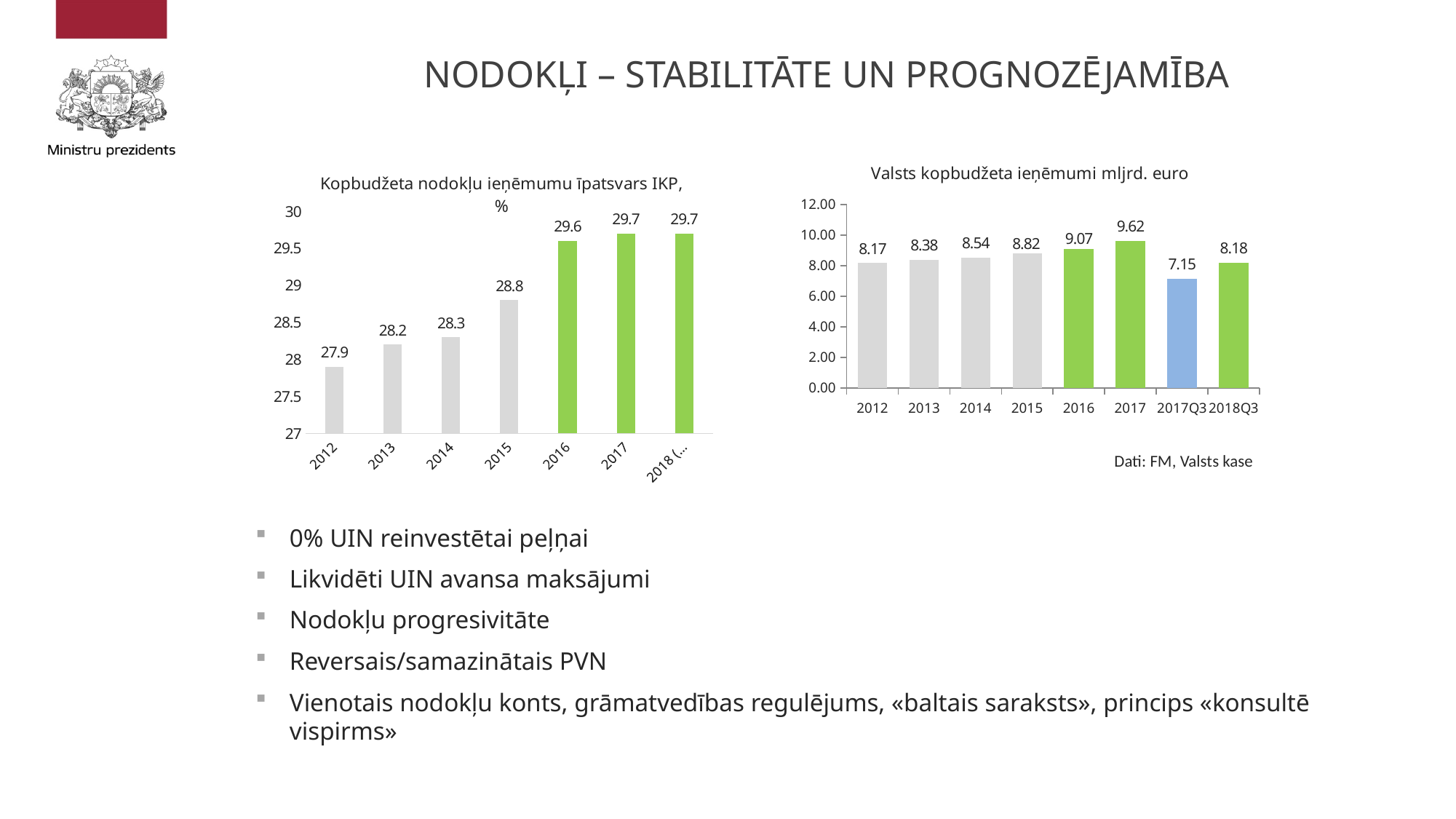
In the chart titled "Valsts kopbudžeta ieņēmumi mljrd. euro", which category has the lowest value? 2017Q3 In the chart titled "Kopbudžeta nodokļu ieņēmumu īpatsvars IKP, %", what is the difference between the values for 2016 and 2015? 0.8 In the chart titled "Valsts kopbudžeta ieņēmumi mljrd. euro", which is larger, the value for 2018Q3 or the value for 2017Q3? 2018Q3 In the chart titled "Kopbudžeta nodokļu ieņēmumu īpatsvars IKP, %", which year from 2012 to 2015 has the lowest value? 2012 In the chart titled "Kopbudžeta nodokļu ieņēmumu īpatsvars IKP, %", do the values rise or fall from 2012 to 2017? rise In the chart titled "Valsts kopbudžeta ieņēmumi mljrd. euro", what is the value for 2017Q3? 7.15 In the chart titled "Valsts kopbudžeta ieņēmumi mljrd. euro", which category has the highest value? 2017 In the chart titled "Valsts kopbudžeta ieņēmumi mljrd. euro", how many bars are shown? 8 In the chart titled "Kopbudžeta nodokļu ieņēmumu īpatsvars IKP, %", what is the value for 2015? 28.8 In the chart titled "Valsts kopbudžeta ieņēmumi mljrd. euro", what is the value for 2017? 9.62 In the chart titled "Kopbudžeta nodokļu ieņēmumu īpatsvars IKP, %", what is the value for 2012? 27.9 What kind of chart is the chart titled "Valsts kopbudžeta ieņēmumi mljrd. euro"? bar chart